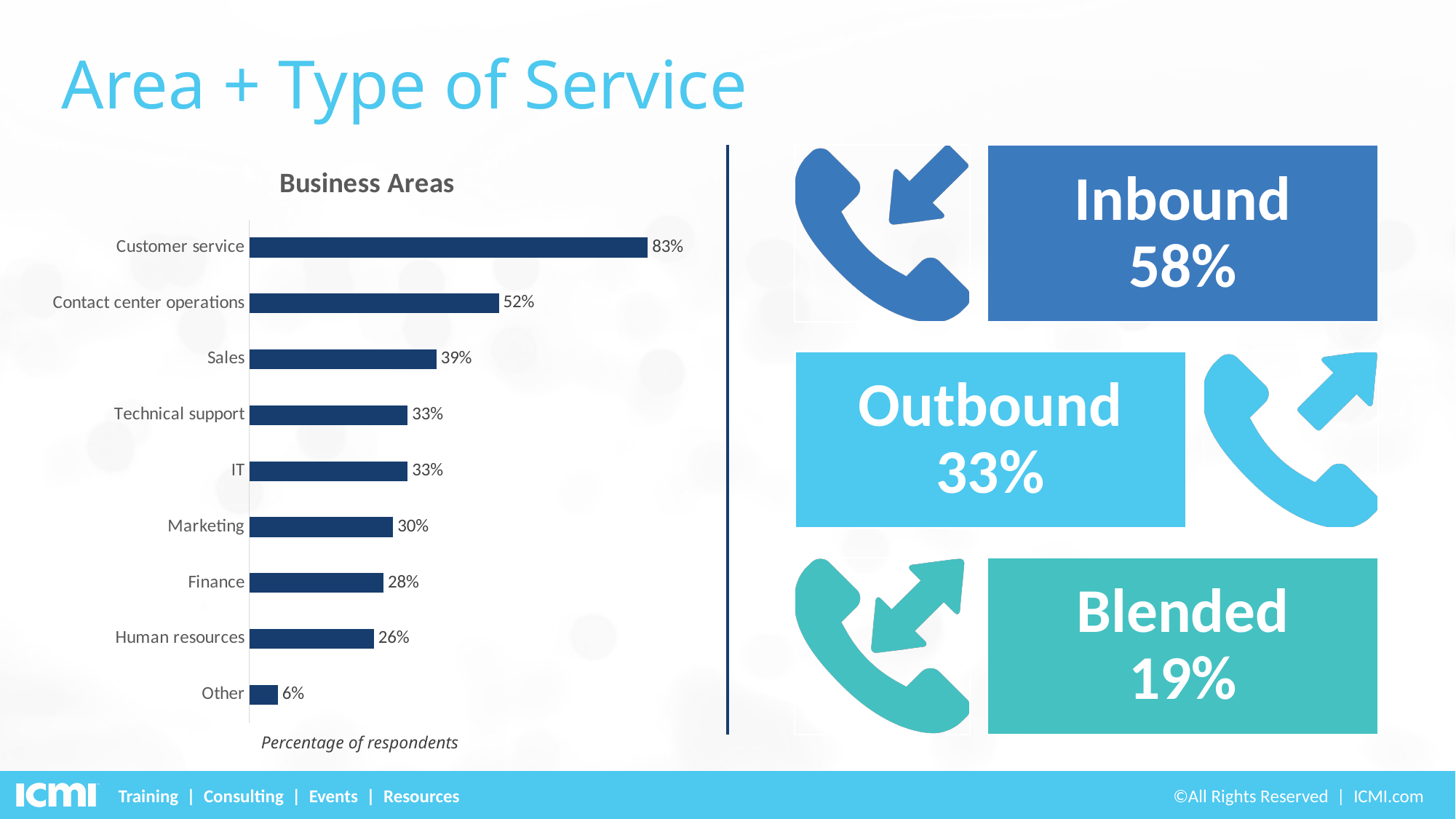
What is the difference between Customer service and Contact center operations in the Business Areas chart? 31% How many business areas are shown in the Business Areas chart? 9 What is the value for Human resources in the Business Areas chart? 26% What is the value for Customer service in the Business Areas chart? 83% Which business area has the lowest percentage of respondents? Other What is the value for Sales in the Business Areas chart? 39% What kind of chart is the Business Areas chart? Bar chart What is the difference between Marketing and Finance in the Business Areas chart? 2% What does the label below the Business Areas chart say the values represent? Percentage of respondents What is the title of the chart on the slide? Business Areas Which business area has the highest percentage of respondents? Customer service Which is larger in the Business Areas chart, Sales or Technical support? Sales